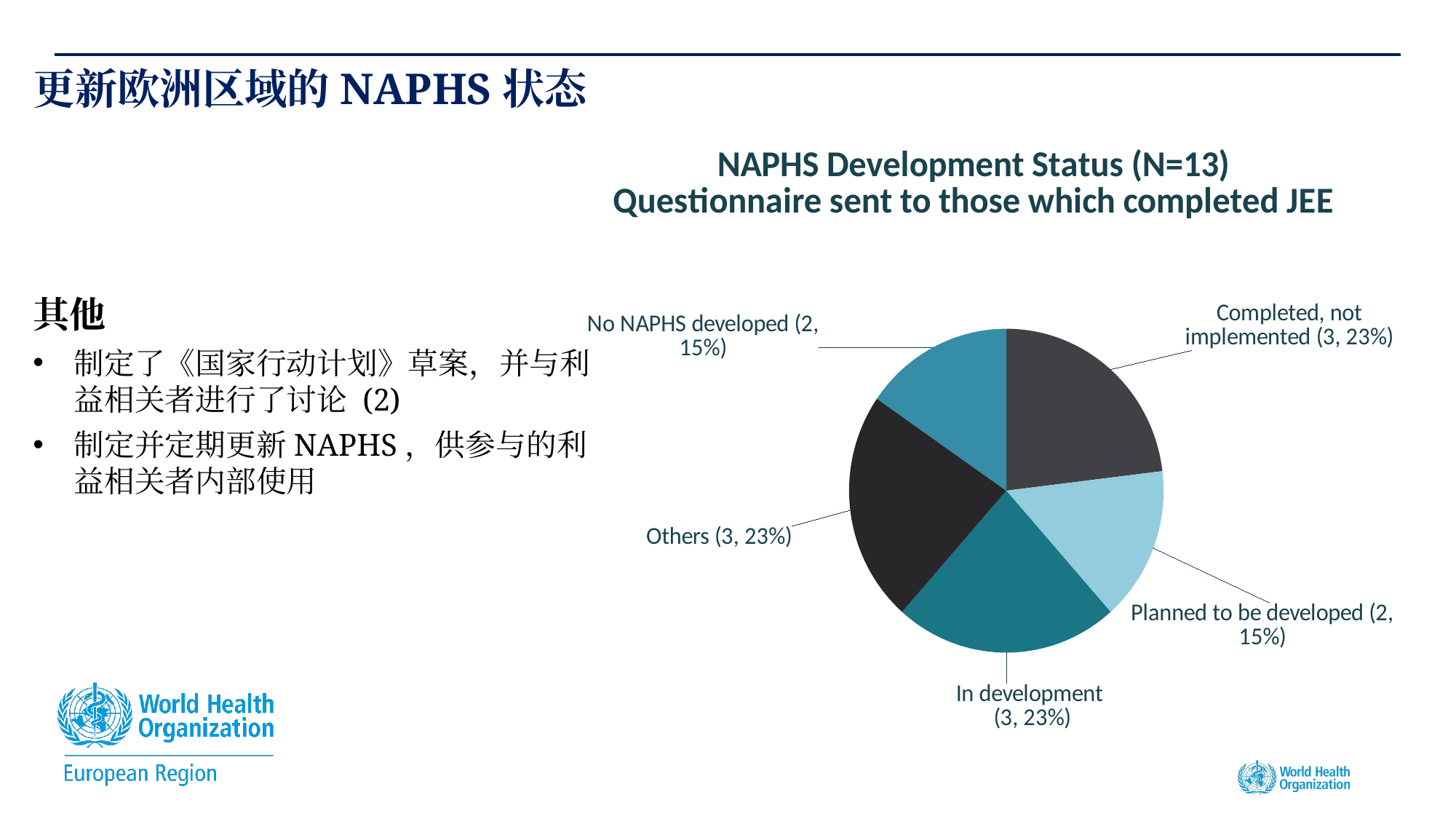
What share of the pie does 'Others' represent? 23% How many countries are in the 'In development' category? 3 How many countries are in the 'Planned to be developed' category? 2 What share of the pie does 'No NAPHS developed' represent? 15% Which is larger, the 'Others' slice or the 'Planned to be developed' slice? Others What share of the pie does 'Completed, not implemented' represent? 23% What is the difference in count between 'In development' and 'No NAPHS developed'? 1 How many slices does the pie chart have? 5 What is the total number of respondents (N) stated in the chart title? 13 Which is larger, the 'Completed, not implemented' slice or the 'No NAPHS developed' slice? Completed, not implemented What is the title of the chart? NAPHS Development Status (N=13) Questionnaire sent to those which completed JEE What kind of chart is shown on the slide? Pie chart